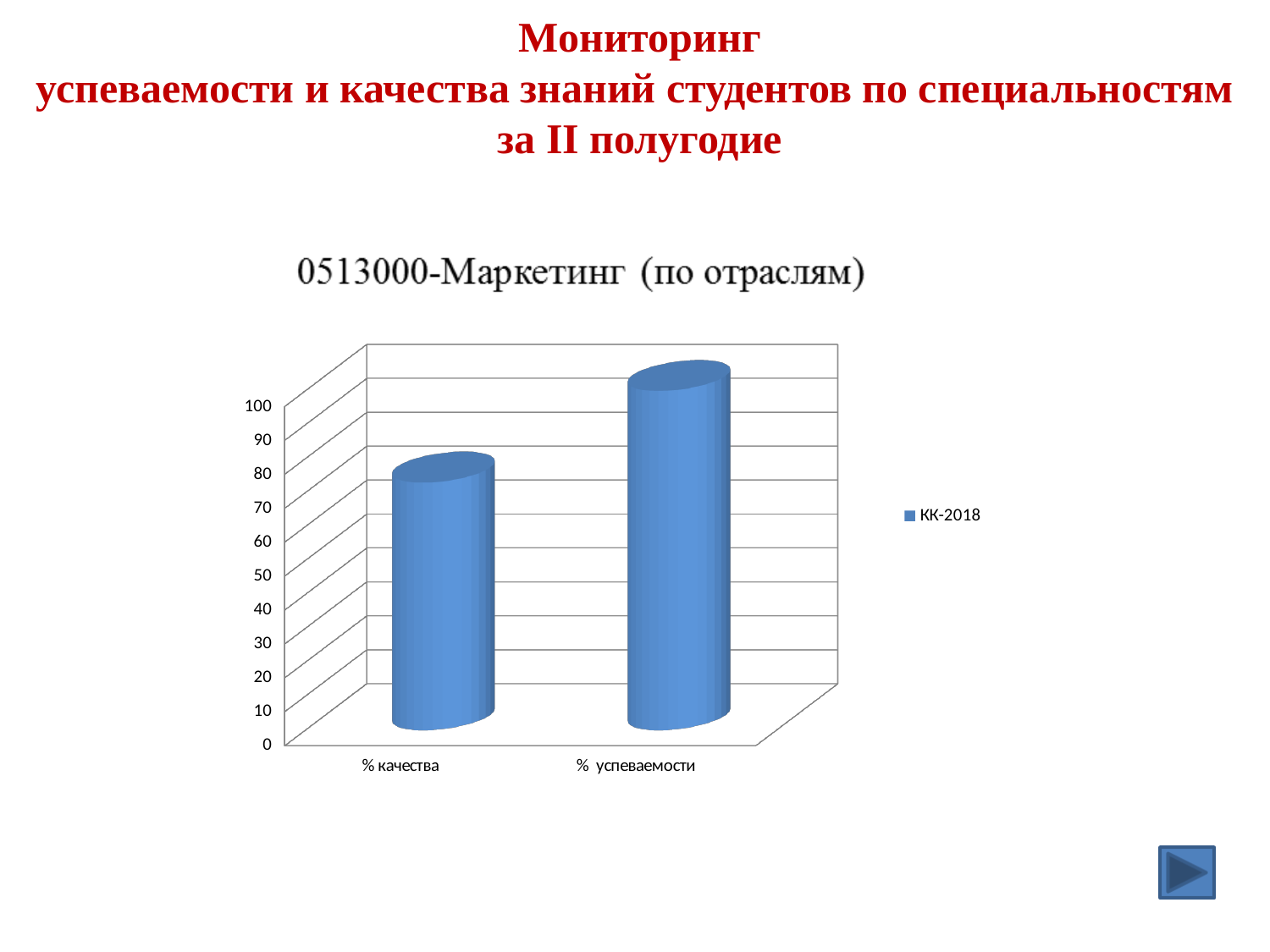
How many categories are plotted on the x axis? 2 Is the value for % качества greater or less than 90? less How many series does the legend list? 1 What series name is shown in the legend? КК-2018 Which category has the lowest bar? % качества What kind of chart is shown on the slide? bar chart Is the value for % успеваемости greater or less than 80? greater Which is larger, the value for % качества or the value for % успеваемости? % успеваемости Do the bar values rise or fall from left to right along the x axis? rise What is the title of the chart? 0513000-Маркетинг (по отраслям) Which category has the highest bar? % успеваемости Is the value for % качества greater or less than 50? greater